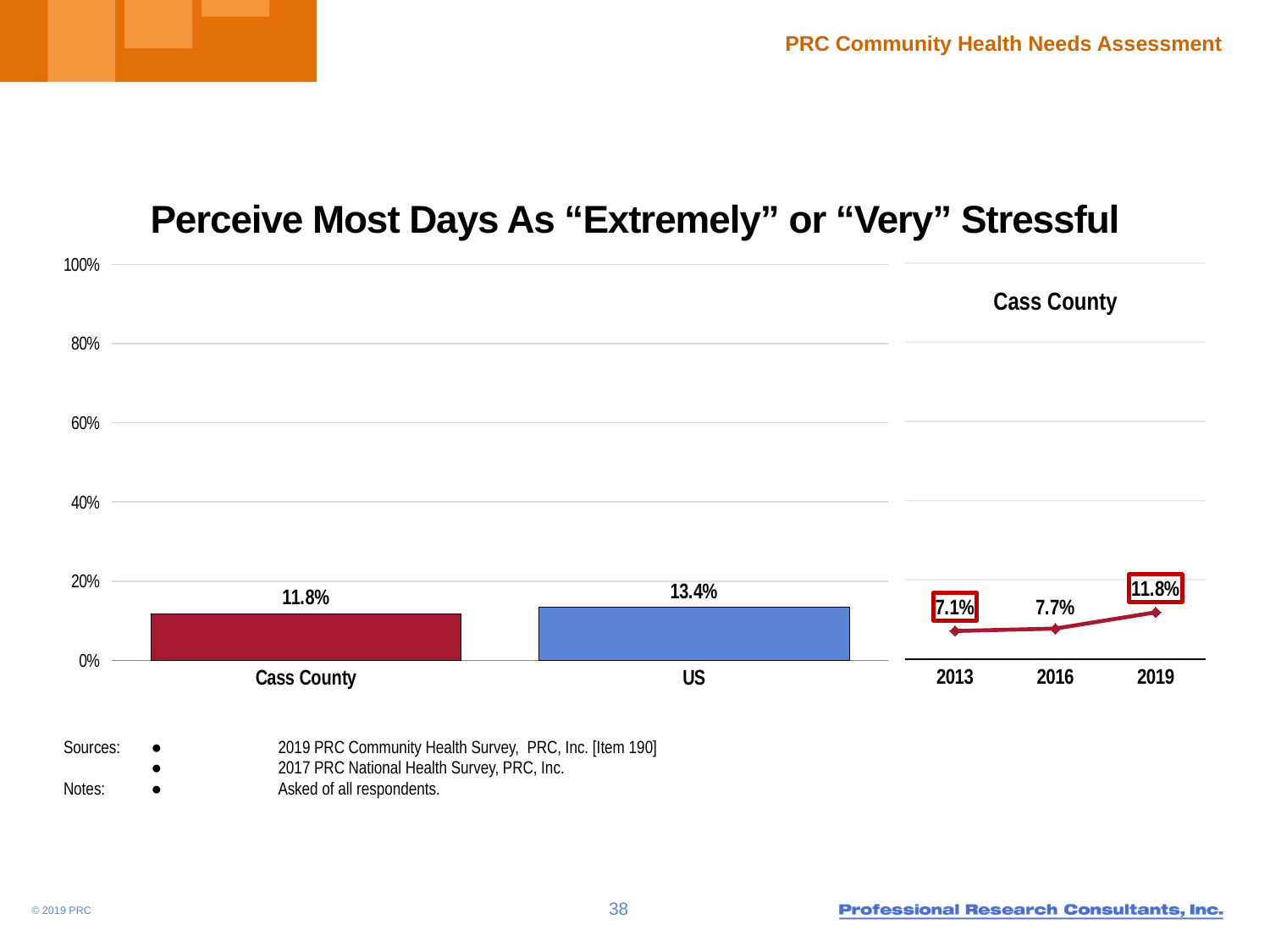
In the Cass County trend chart on the right, what is the value for 2013? 7.1% In the bar chart on the left, what is the value for US? 13.4% In the bar chart on the left, how many categories are shown? 2 In the Cass County trend chart on the right, what is the value for 2016? 7.7% In the Cass County trend chart on the right, which year has the lowest value? 2013 In the Cass County trend chart on the right, do the values rise or fall from 2013 to 2019? rise In the bar chart on the left, what is the value for Cass County? 11.8% In the bar chart on the left, which category has the higher value, Cass County or US? US In the bar chart on the left, what is the difference between the US value and the Cass County value? 1.6% In the Cass County trend chart on the right, what is the difference between the 2019 value and the 2013 value? 4.7% What kind of chart is the chart on the left? bar chart In the Cass County trend chart on the right, which year has the highest value? 2019